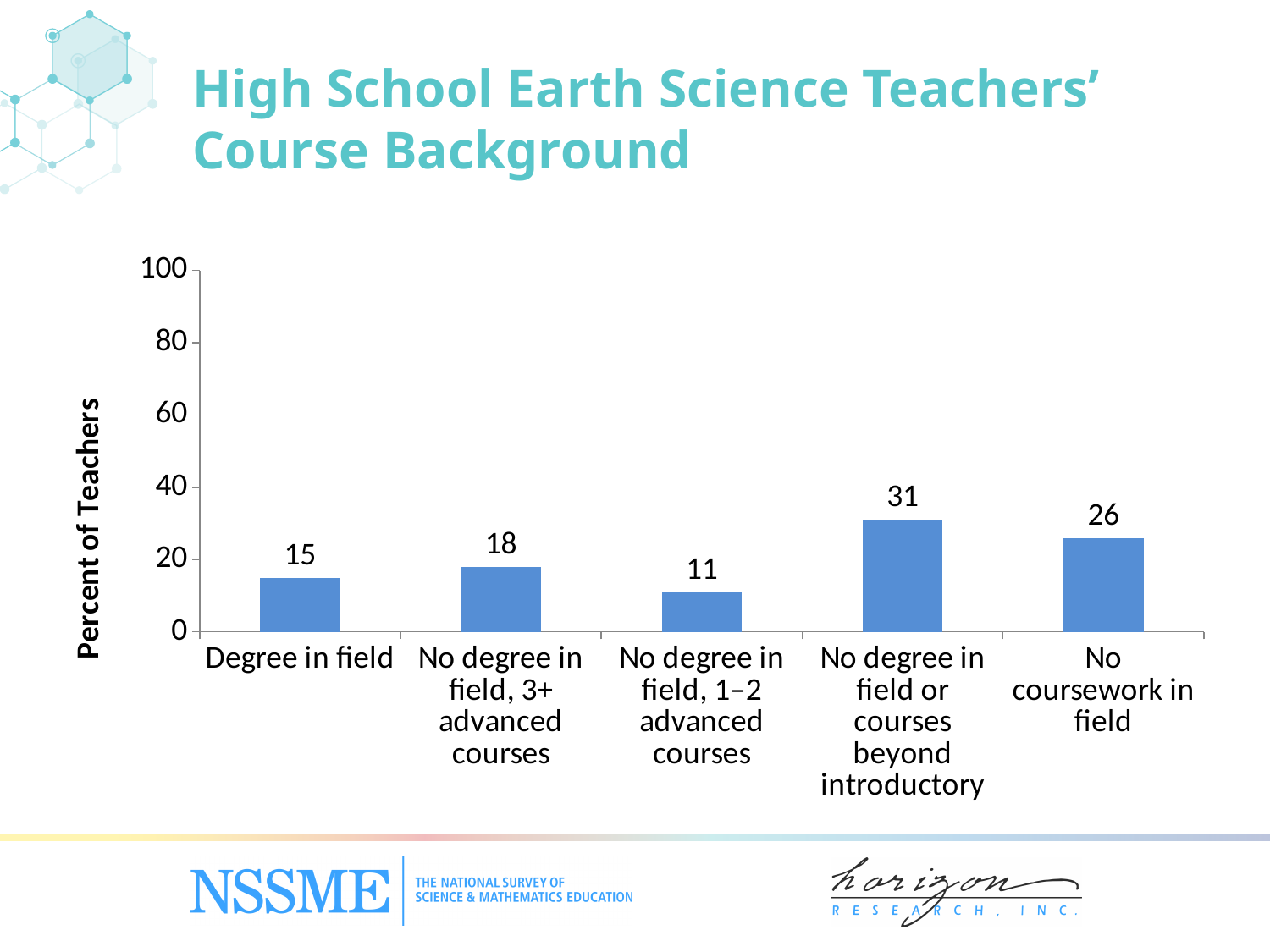
Which category has the lowest percent of teachers? No degree in field, 1–2 advanced courses What is the value for 'No degree in field, 1–2 advanced courses'? 11 Which is larger: 'Degree in field' or 'No degree in field, 3+ advanced courses'? No degree in field, 3+ advanced courses Which category has the highest percent of teachers? No degree in field or courses beyond introductory What percent of teachers have no coursework in field? 26 Is the value for 'No degree in field or courses beyond introductory' greater or less than 20? greater What is the label of the y axis? Percent of Teachers How many categories are shown on the x axis? 5 What is the difference between 'No degree in field or courses beyond introductory' and 'No coursework in field'? 5 What is the title of the slide? High School Earth Science Teachers' Course Background What percent of teachers have a degree in field? 15 What kind of chart is shown on the slide? Bar chart